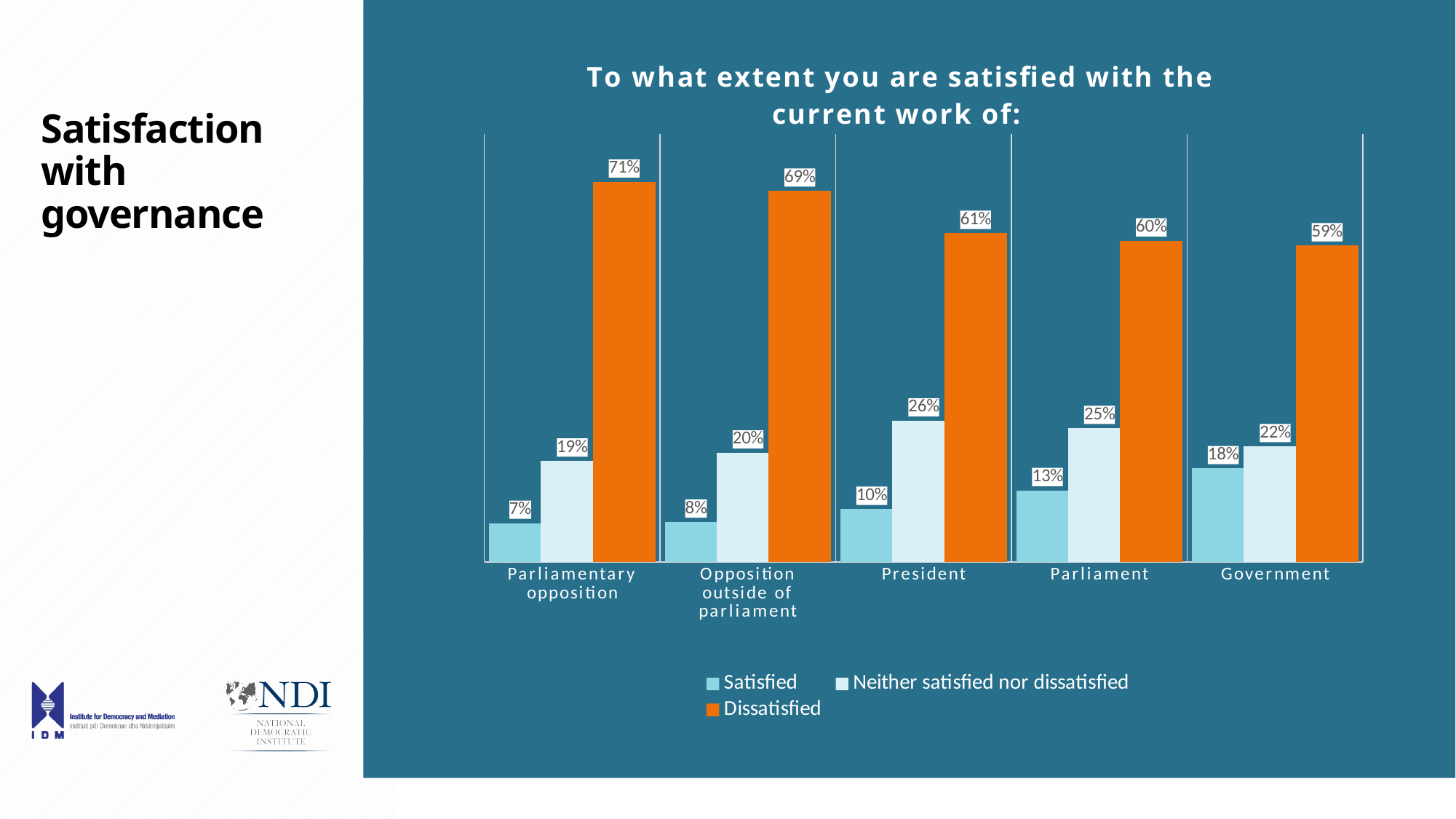
What is the 'Satisfied' value for the President? 10% Which category has the highest 'Satisfied' value? Government How many categories are shown on the x axis? 5 Which is larger: the 'Neither satisfied nor dissatisfied' value for the President or for Parliament? President What kind of chart is shown on the slide? Bar chart Do the 'Dissatisfied' values rise or fall from left to right across the categories? Fall What is the difference between the 'Dissatisfied' values for the Parliamentary opposition and the Government? 12% Which category has the lowest 'Dissatisfied' value? Government What percentage of respondents are dissatisfied with the current work of the Parliamentary opposition? 71% What is the 'Neither satisfied nor dissatisfied' value for the Government? 22% How many series does the legend list? 3 Which colour represents the 'Dissatisfied' series? Orange